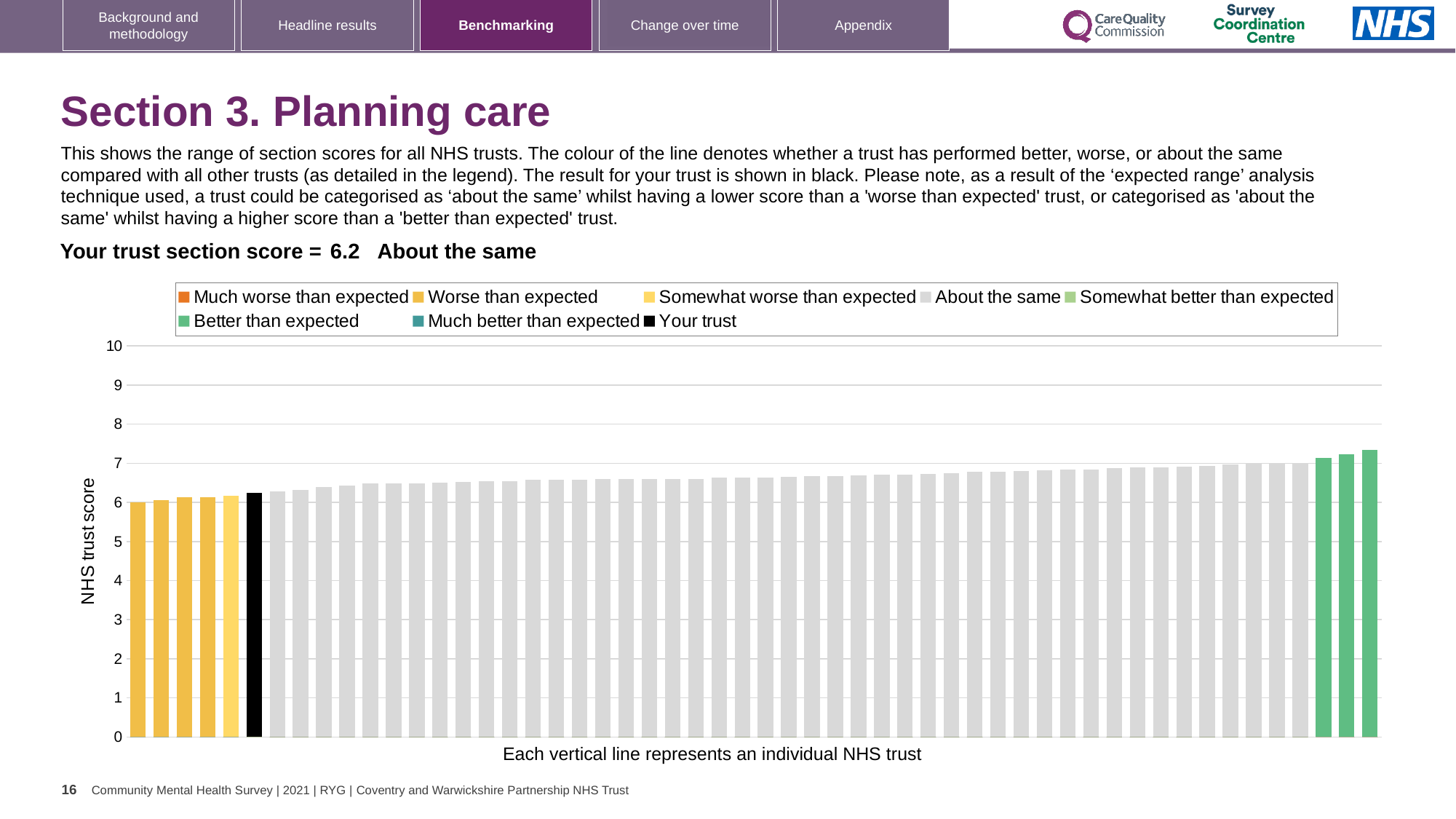
What is the label on the vertical axis of the chart? NHS trust score Is the value of the highest bar in the chart greater or less than 7? greater How many bars appear to the left of the black 'Your trust' bar? 5 Do the bar values rise or fall from left to right along the x axis? rise What is the section score for your trust shown on the slide? 6.2 Is the value of the lowest bar in the chart greater or less than 5? greater What kind of chart is shown on the slide? Bar chart How many bars are coloured green (better than expected) in the chart? 3 What colour is used for the 'Your trust' bar in the chart? Black Is the value for your trust (the black bar) greater or less than 7? less How many entries does the chart legend list? 8